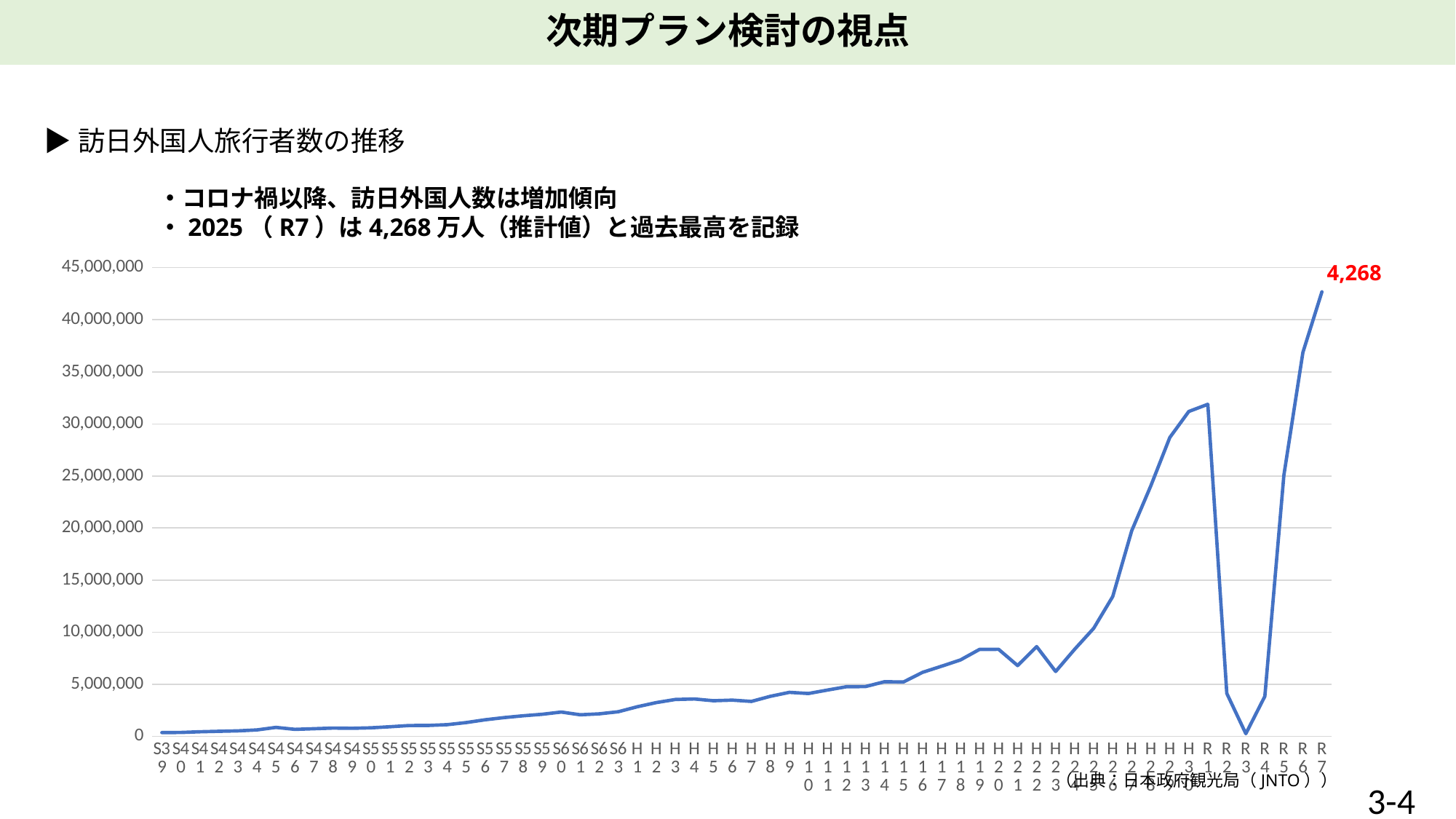
Overall, do the values rise or fall from S39 to R7? rise Is the value for H20 greater or less than 10,000,000? less Which is larger, the value for R1 or the value for R3? R1 Is the value for H28 greater or less than 20,000,000? greater What is the source cited below the chart? 日本政府観光局（JNTO） Which year has the highest value on the chart? R7 Is the value for R1 greater or less than 30,000,000? greater What kind of chart is shown on the slide? line chart Which is larger, the value for R6 or the value for H30? R6 What value is labelled on the chart for R7? 4,268